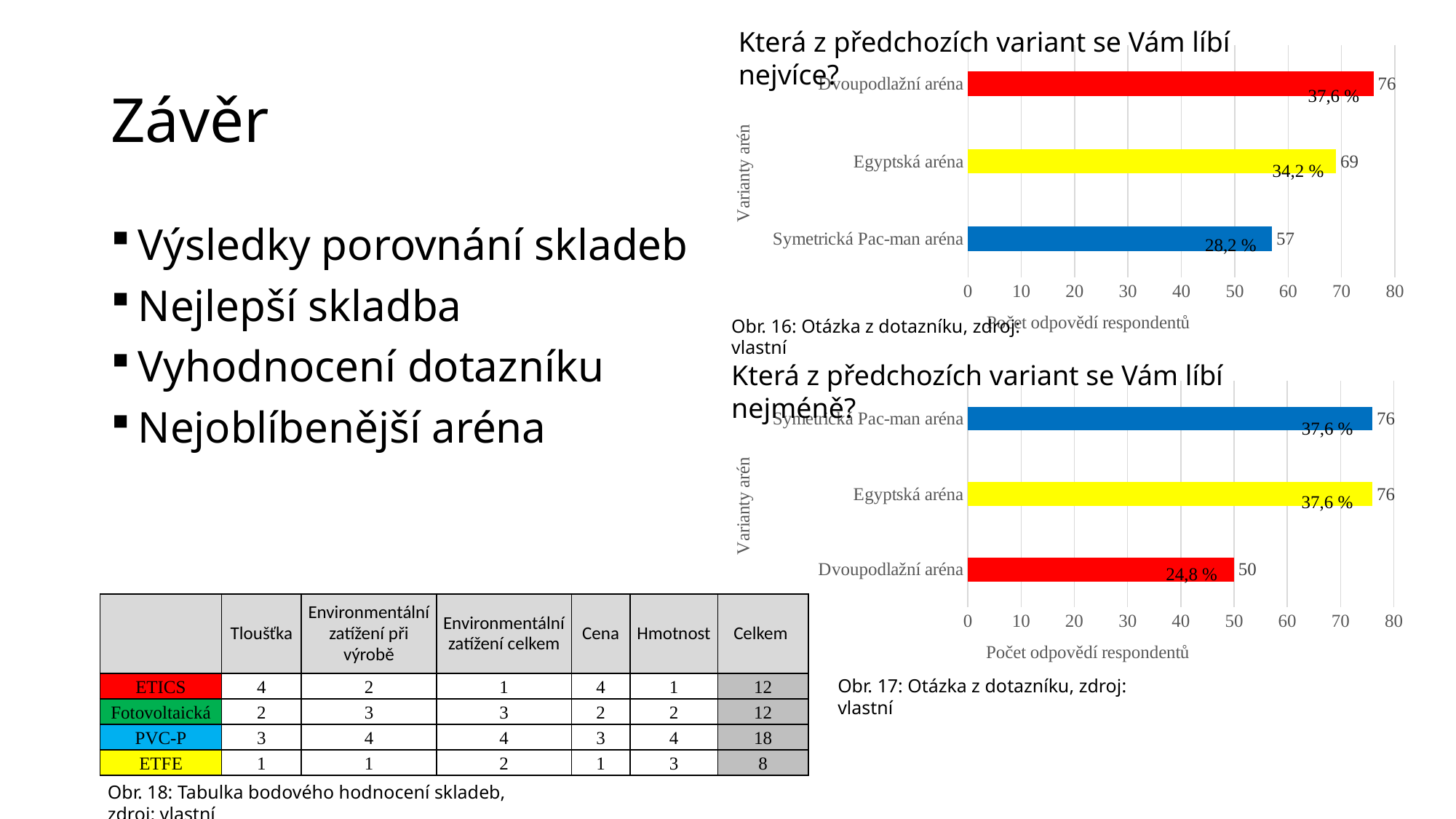
In the bottom chart, which arena variant has the lowest number of responses? Dvoupodlažní aréna In the bottom chart ("Která z předchozích variant se Vám líbí nejméně?"), how many responses did Dvoupodlažní aréna receive? 50 What type of chart is the top chart on the slide? Bar chart In the bottom chart, which has more responses: Egyptská aréna or Dvoupodlažní aréna? Egyptská aréna What is the x-axis label of the bottom chart? Počet odpovědí respondentů In the top chart, which arena variant has the lowest number of responses? Symetrická Pac-man aréna In the bottom chart, what is the difference in responses between Egyptská aréna and Dvoupodlažní aréna? 26 In the top chart, what is the difference in responses between Dvoupodlažní aréna and Symetrická Pac-man aréna? 19 In the bottom chart, what percentage label is shown for Symetrická Pac-man aréna? 37,6 % In the top chart, what percentage label is shown for Egyptská aréna? 34,2 % In the top chart, how many arena variants are plotted? 3 In the top chart ("Která z předchozích variant se Vám líbí nejvíce?"), how many responses did Dvoupodlažní aréna receive? 76